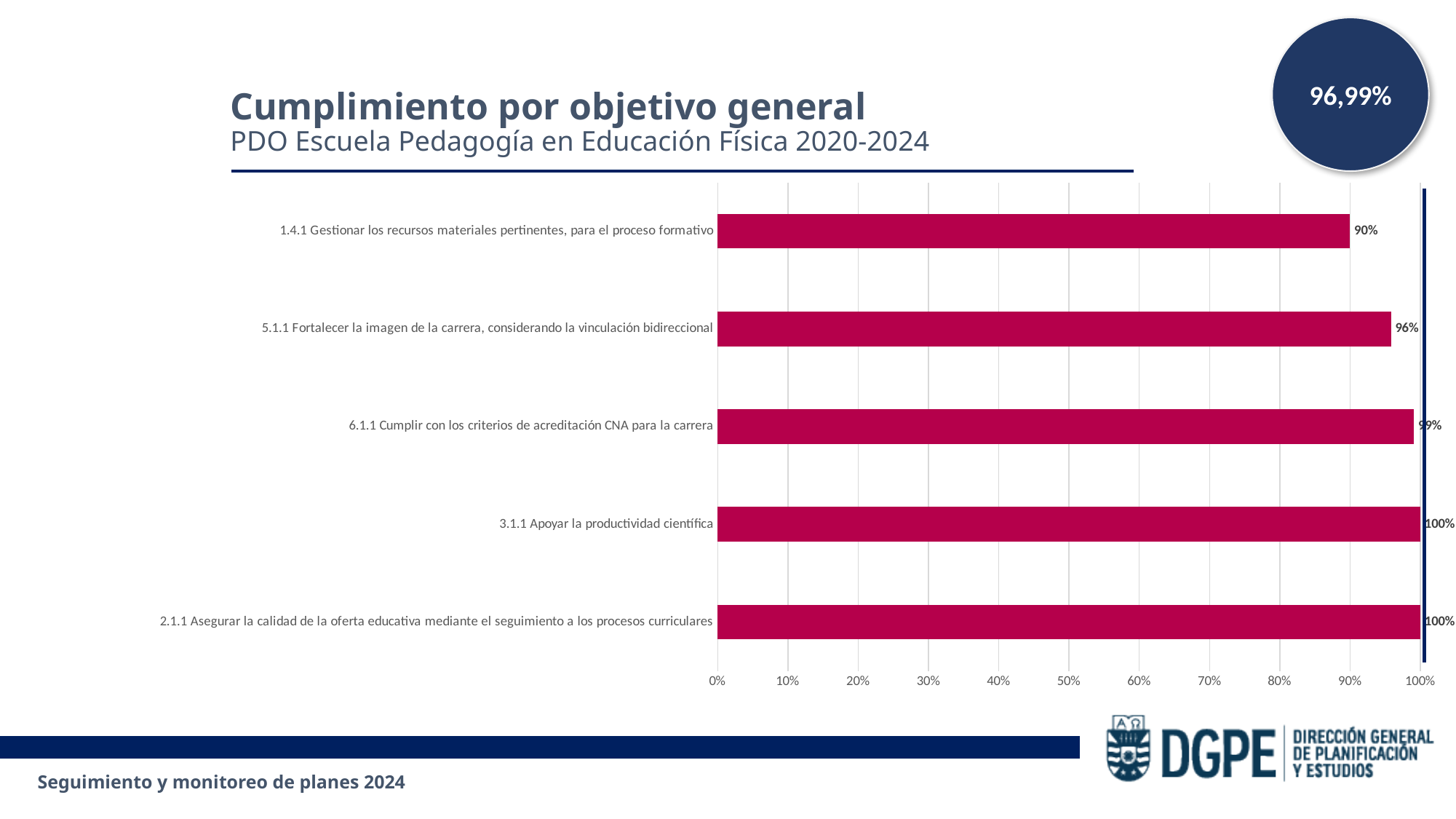
How many objectives reach 100%? 2 What is the difference between the values for 5.1.1 and 1.4.1? 6% What is the value for '6.1.1 Cumplir con los criterios de acreditación CNA para la carrera'? 99% What is the value for '1.4.1 Gestionar los recursos materiales pertinentes, para el proceso formativo'? 90% What overall percentage is shown in the circle at the top right of the slide? 96,99% How many objectives are shown in the chart? 5 Which is larger, the value for 5.1.1 or the value for 1.4.1? 5.1.1 What is the value for '3.1.1 Apoyar la productividad científica'? 100% Which objective has the lowest value? 1.4.1 Gestionar los recursos materiales pertinentes, para el proceso formativo What kind of chart is shown on the slide? Bar chart What is the value for '5.1.1 Fortalecer la imagen de la carrera, considerando la vinculación bidireccional'? 96% What is the difference between the values for 3.1.1 and 6.1.1? 1%